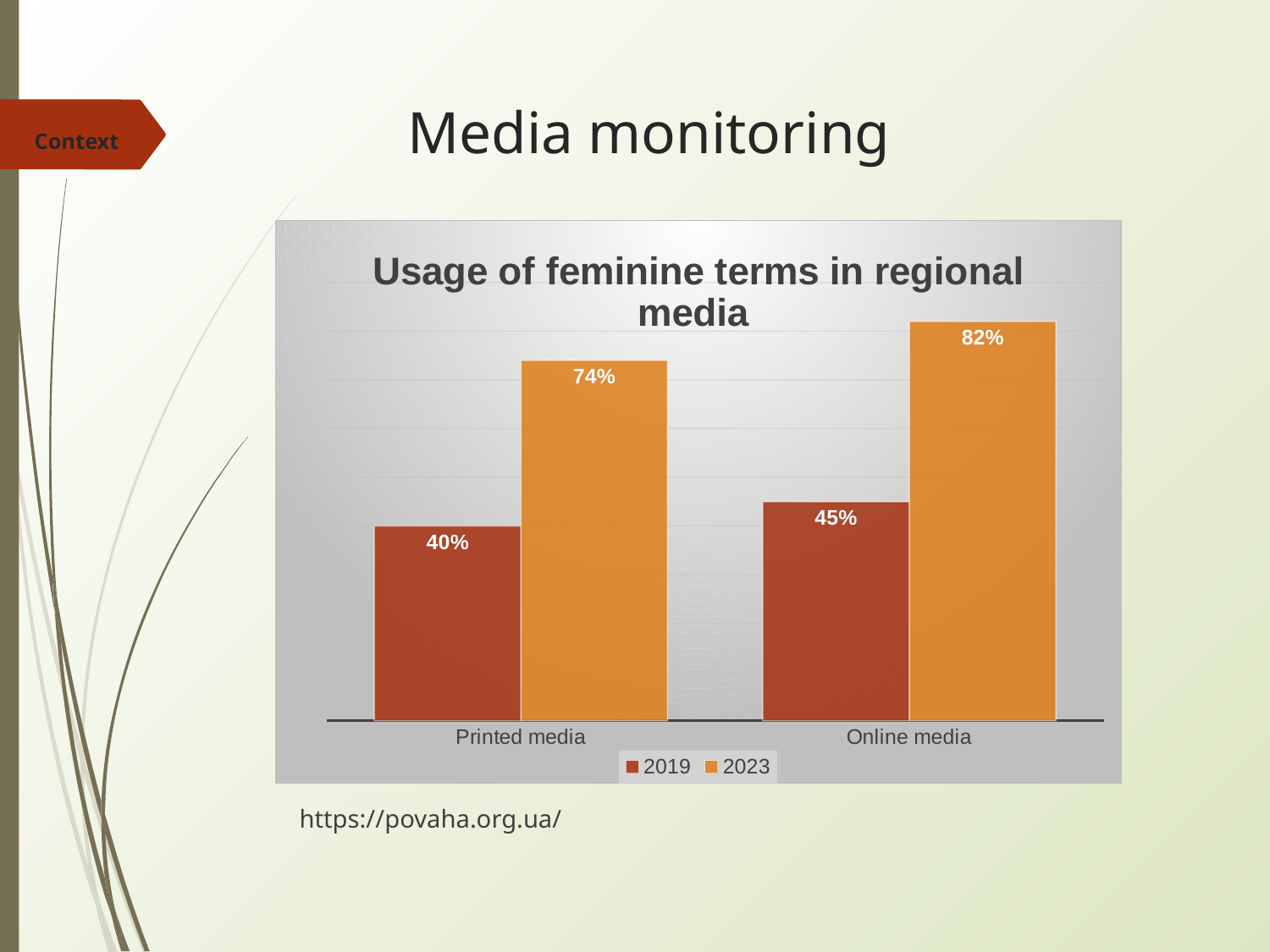
What type of chart is shown? Bar chart How many categories are shown on the x axis? 2 What is the value for Printed media in 2019? 40% What is the value for Printed media in 2023? 74% Which is larger: the 2019 value for Online media or the 2019 value for Printed media? Online media How many series does the legend list? 2 What is the difference between the 2023 and 2019 values for Online media? 37% What is the difference between the 2023 and 2019 values for Printed media? 34% Which category has the highest value in the 2023 series? Online media Which category has the lowest value in the 2019 series? Printed media What is the value for Online media in 2023? 82% What is the value for Online media in 2019? 45%